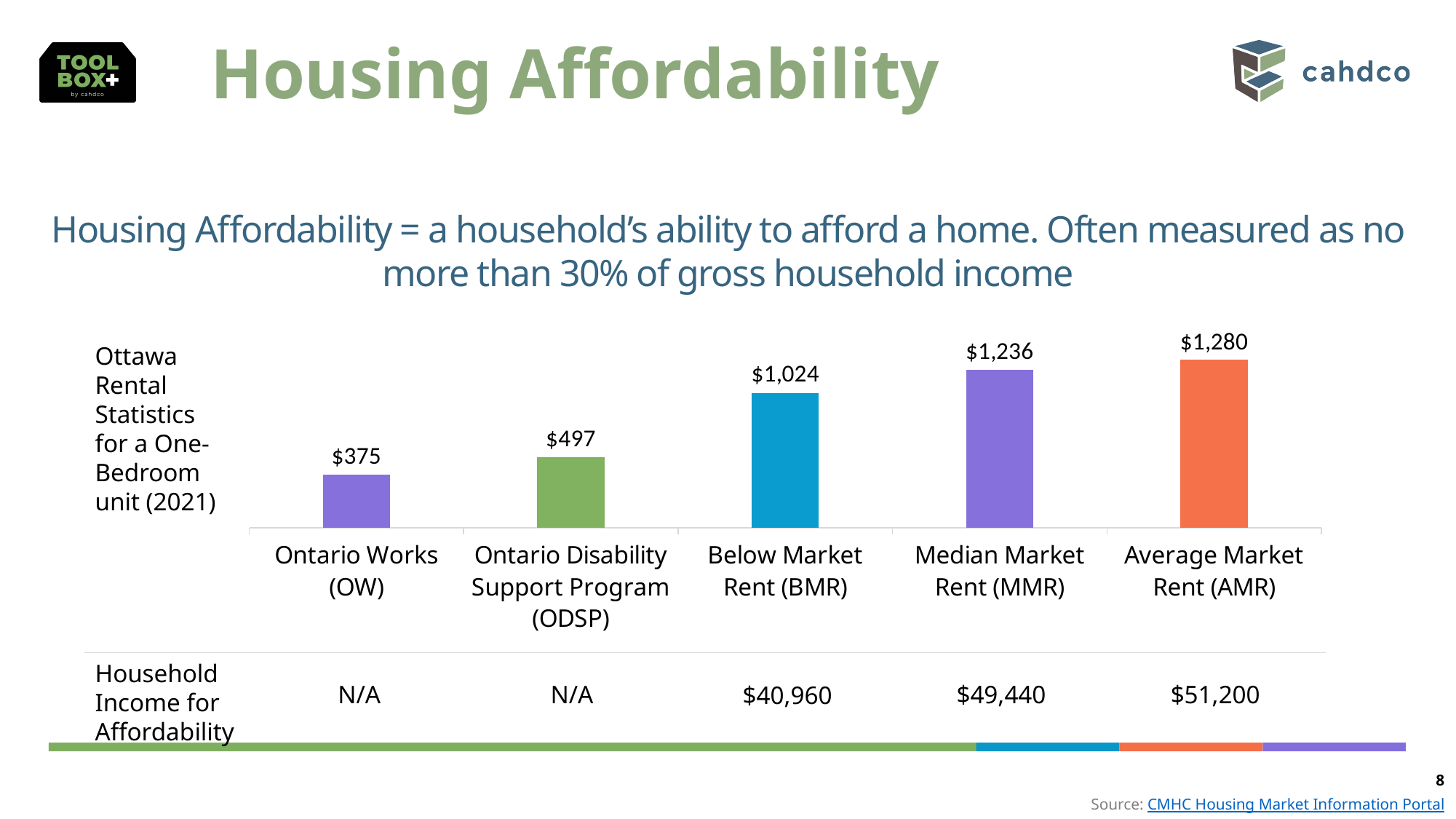
What kind of chart is shown on the slide? Bar chart What is the value for Ontario Works (OW)? $375 How many categories are shown in the chart? 5 Which category has the lowest value? Ontario Works (OW) Which category has the highest value? Average Market Rent (AMR) What is the value for Average Market Rent (AMR)? $1,280 What is the difference between the values for Median Market Rent (MMR) and Below Market Rent (BMR)? $212 Which is larger, the value for Ontario Disability Support Program (ODSP) or Below Market Rent (BMR)? Below Market Rent (BMR) What is the value for Below Market Rent (BMR)? $1,024 What is the value for Median Market Rent (MMR)? $1,236 What is the difference between the values for Average Market Rent (AMR) and Ontario Works (OW)? $905 What is the value for Ontario Disability Support Program (ODSP)? $497